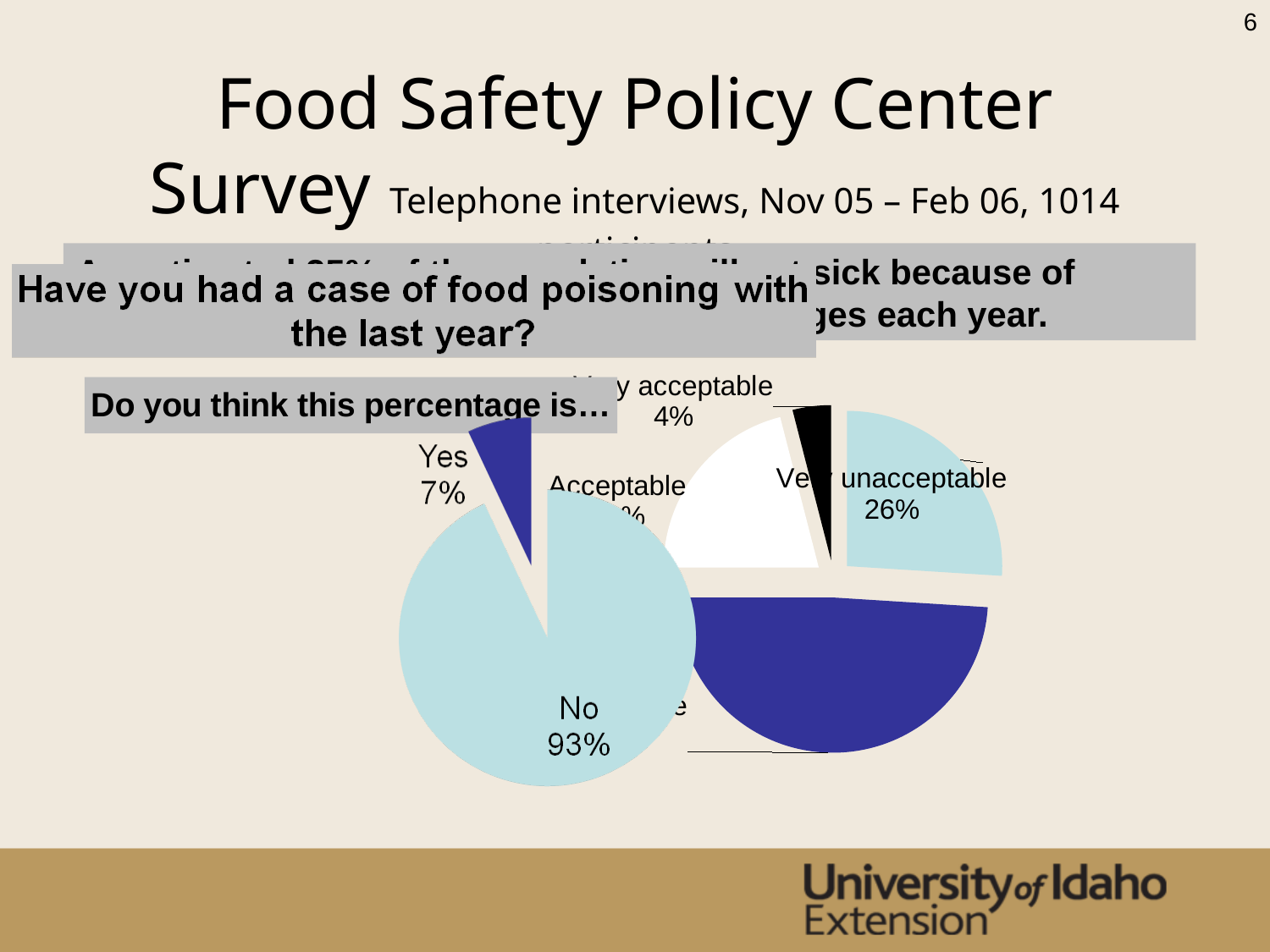
In the 'Do you think this percentage is…' pie chart, which labelled slice is the smallest? Very acceptable In the pie chart for 'Have you had a case of food poisoning with the last year?', what percentage answered No? 93% How many pie charts are shown on the slide? 2 In the food poisoning pie chart, what is the difference in percentage points between the No and Yes slices? 86 percentage points What kind of chart is used for the 'Have you had a case of food poisoning' question? Pie chart In the pie chart for 'Have you had a case of food poisoning with the last year?', what percentage answered Yes? 7% How many slices does the food poisoning pie chart have? 2 In the 'Do you think this percentage is…' pie chart, which is larger, Very acceptable or Very unacceptable? Very unacceptable In the food poisoning pie chart, which slice is larger, Yes or No? No In the 'Do you think this percentage is…' pie chart, what is the difference in percentage points between Very unacceptable and Very acceptable? 22 percentage points In the pie chart for 'Do you think this percentage is…', what share is labelled Very unacceptable? 26% In the pie chart for 'Do you think this percentage is…', what share is labelled Very acceptable? 4%